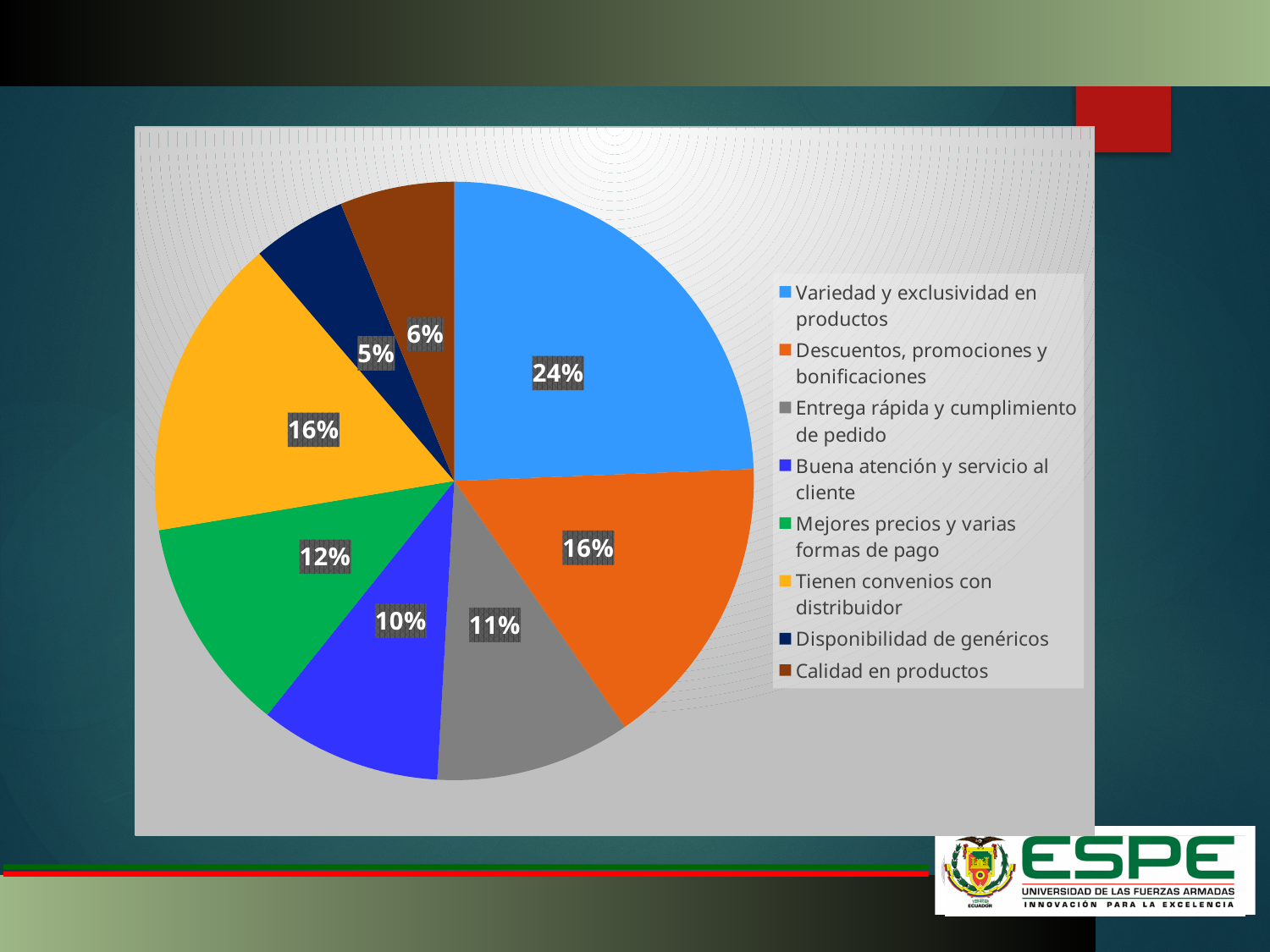
What share of the pie is 'Buena atención y servicio al cliente'? 10% What share of the pie is 'Variedad y exclusividad en productos'? 24% What share of the pie is 'Entrega rápida y cumplimiento de pedido'? 11% What colour is the slice for 'Tienen convenios con distribuidor'? yellow What kind of chart is shown on the slide? pie chart How many slices does the pie chart have? 8 What is the difference between the shares of 'Variedad y exclusividad en productos' and 'Mejores precios y varias formas de pago'? 12% Which is larger: the share for 'Mejores precios y varias formas de pago' or the share for 'Calidad en productos'? Mejores precios y varias formas de pago Which category has the smallest share of the pie? Disponibilidad de genéricos What share of the pie is 'Disponibilidad de genéricos'? 5% Which category has the largest share of the pie? Variedad y exclusividad en productos What is the combined share of 'Disponibilidad de genéricos' and 'Calidad en productos'? 11%